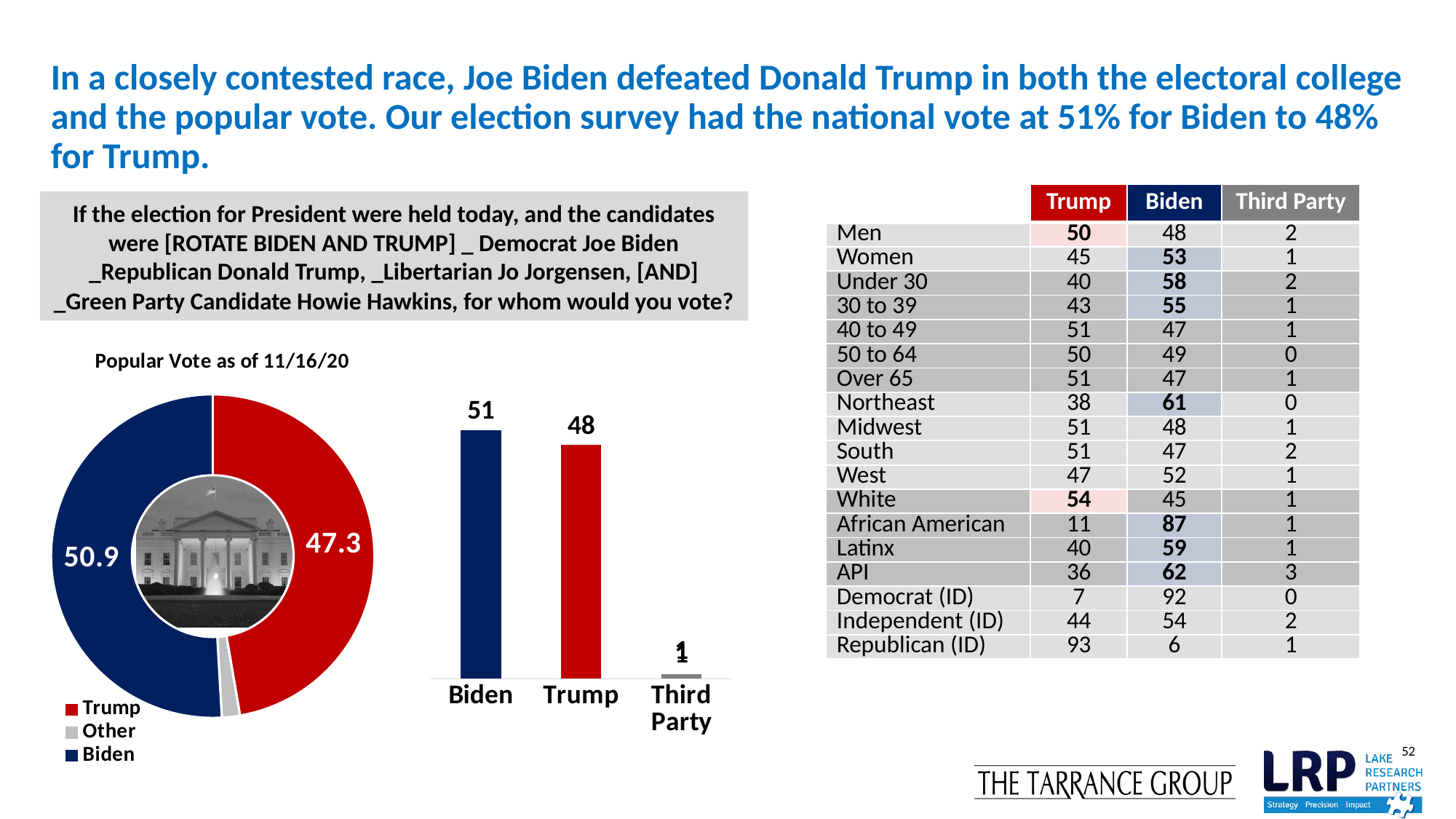
How many entries does the legend of the 'Popular Vote as of 11/16/20' chart list? 3 In the bar chart to the right of the pie chart, what is the value for Biden? 51 What kind of chart is the 'Popular Vote as of 11/16/20' chart? Pie (doughnut) chart In the bar chart to the right of the pie chart, what is the difference between the Biden and Trump values? 3 In the bar chart to the right of the pie chart, which category has the highest value? Biden How many categories are shown in the bar chart to the right of the pie chart? 3 In the bar chart to the right of the pie chart, which category has the lowest value? Third Party In the 'Popular Vote as of 11/16/20' chart, what is the difference between the Biden and Trump values? 3.6 In the 'Popular Vote as of 11/16/20' chart, which candidate has the larger slice, Biden or Trump? Biden In the 'Popular Vote as of 11/16/20' chart, what is the value shown for Biden? 50.9 In the 'Popular Vote as of 11/16/20' chart, what is the value shown for Trump? 47.3 In the bar chart to the right of the pie chart, what is the value for Trump? 48